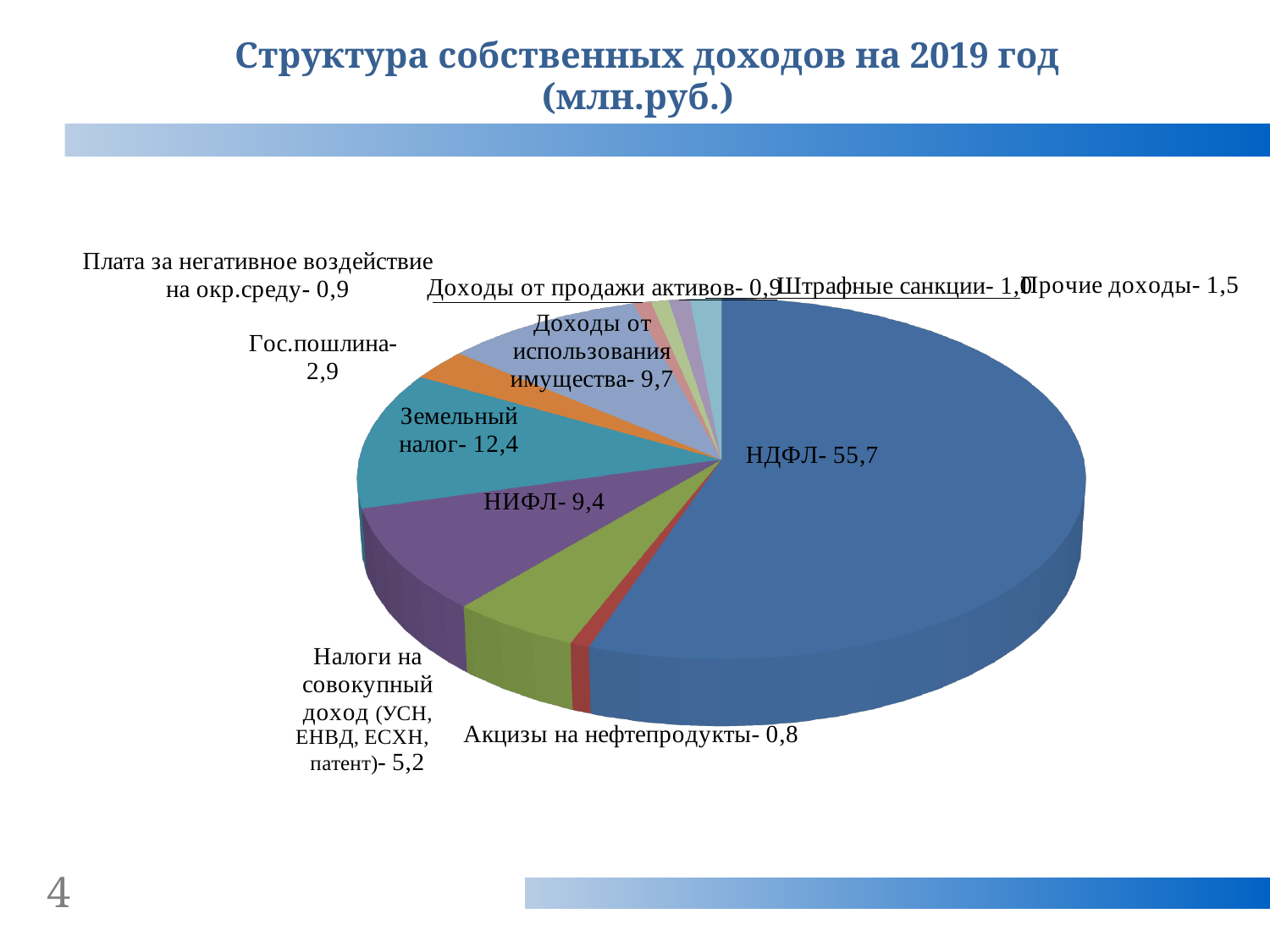
What is the value for Гос.пошлина? 2,9 Which is larger, the value for Земельный налог or the value for Доходы от использования имущества? Земельный налог How many categories (slices) does the pie chart have? 11 What is the value for НДФЛ? 55,7 What is the value for Земельный налог? 12,4 What is the title of the chart on the slide? Структура собственных доходов на 2019 год (млн.руб.) Which category has the smallest value in the chart? Акцизы на нефтепродукты Which category has the largest slice of the pie? НДФЛ What kind of chart is shown on the slide? Pie chart What is the difference between the values for НДФЛ and Земельный налог? 43,3 What is the value for Налоги на совокупный доход (УСН, ЕНВД, ЕСХН, патент)? 5,2 What is the value for Доходы от использования имущества? 9,7